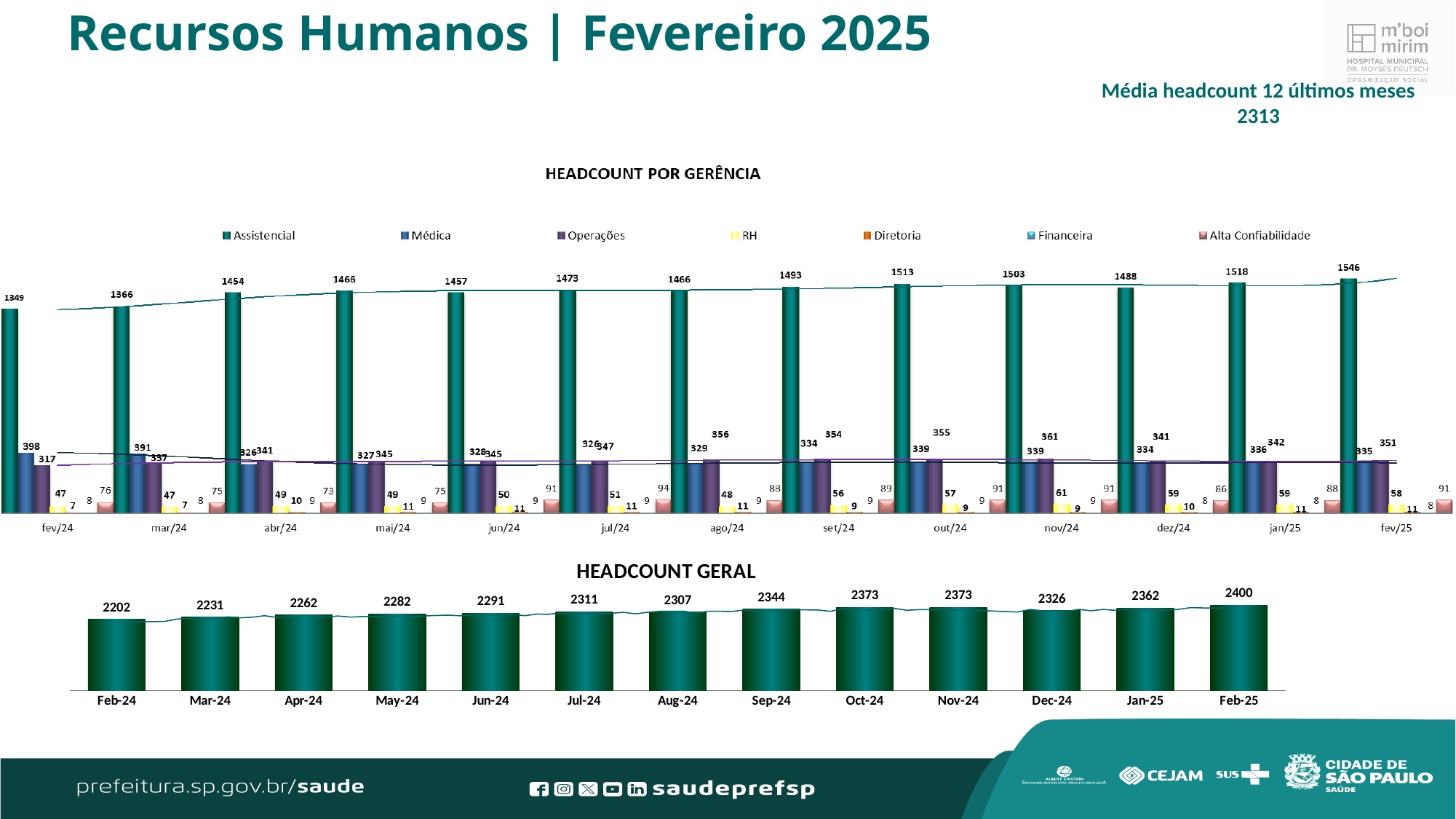
In the HEADCOUNT POR GERÊNCIA chart, what is the difference between the Assistencial values for fev/25 and fev/24? 197 In the HEADCOUNT GERAL chart, how many months are plotted? 13 In the HEADCOUNT GERAL chart, which month has the lowest headcount? Feb-24 In the HEADCOUNT GERAL chart, what is the difference between the Feb-25 and Feb-24 values? 198 How many series does the legend of the HEADCOUNT POR GERÊNCIA chart list? 7 In the HEADCOUNT POR GERÊNCIA chart, what is the Assistencial value for fev/25? 1546 What kind of chart is the HEADCOUNT GERAL chart? bar chart In the HEADCOUNT POR GERÊNCIA chart, what is the Assistencial value for fev/24? 1349 In the HEADCOUNT GERAL chart, which is larger, the value for Oct-24 or Dec-24? Oct-24 In the HEADCOUNT GERAL chart, which month has the highest headcount? Feb-25 In the HEADCOUNT GERAL chart, what is the value for Feb-25? 2400 In the HEADCOUNT GERAL chart, do the values generally rise or fall from Feb-24 to Feb-25? rise